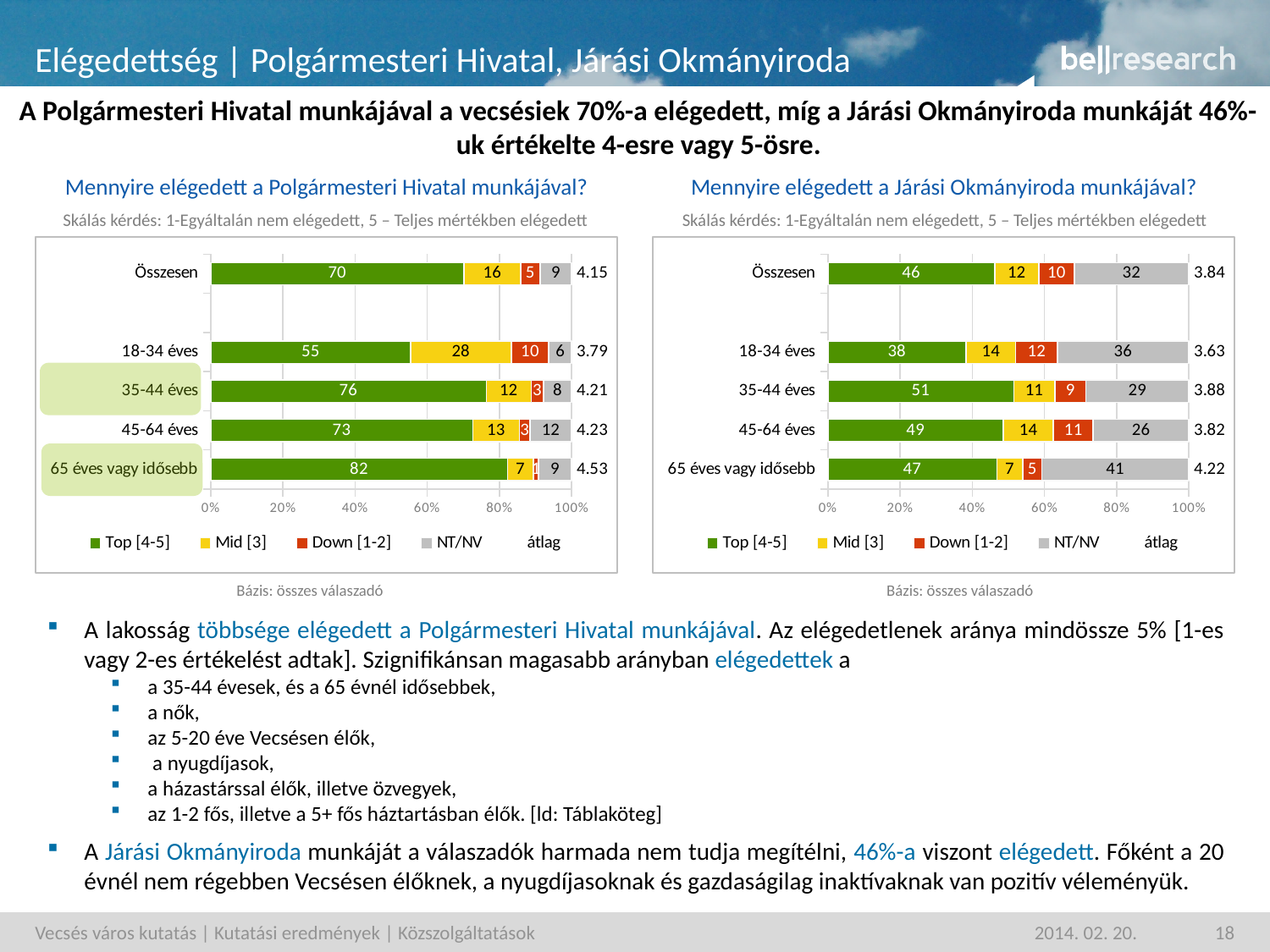
In the chart 'Mennyire elégedett a Járási Okmányiroda munkájával?', what is the NT/NV value for 65 éves vagy idősebb? 41 In the chart 'Mennyire elégedett a Polgármesteri Hivatal munkájával?', what is the difference between the Top [4-5] values for 35-44 éves and 18-34 éves? 21 In the chart 'Mennyire elégedett a Polgármesteri Hivatal munkájával?', what is the átlag (average) value shown for 65 éves vagy idősebb? 4.53 In the chart 'Mennyire elégedett a Polgármesteri Hivatal munkájával?', which age category has the highest Top [4-5] value? 65 éves vagy idősebb What kind of chart is 'Mennyire elégedett a Járási Okmányiroda munkájával?'? Stacked bar chart How many entries does the legend list in the chart 'Mennyire elégedett a Polgármesteri Hivatal munkájával?'? 5 In the chart 'Mennyire elégedett a Polgármesteri Hivatal munkájával?', what is the Top [4-5] value for Összesen? 70 In the chart 'Mennyire elégedett a Járási Okmányiroda munkájával?', which is larger: the Mid [3] value for 45-64 éves or for 35-44 éves? 45-64 éves In the chart 'Mennyire elégedett a Járási Okmányiroda munkájával?', which category has the lowest Top [4-5] value? 18-34 éves In the chart 'Mennyire elégedett a Járási Okmányiroda munkájával?', what is the Down [1-2] value for Összesen? 10 How many categories (bars) are shown in the chart 'Mennyire elégedett a Járási Okmányiroda munkájával?'? 5 In the chart 'Mennyire elégedett a Járási Okmányiroda munkájával?', what is the átlag (average) value shown for 18-34 éves? 3.63